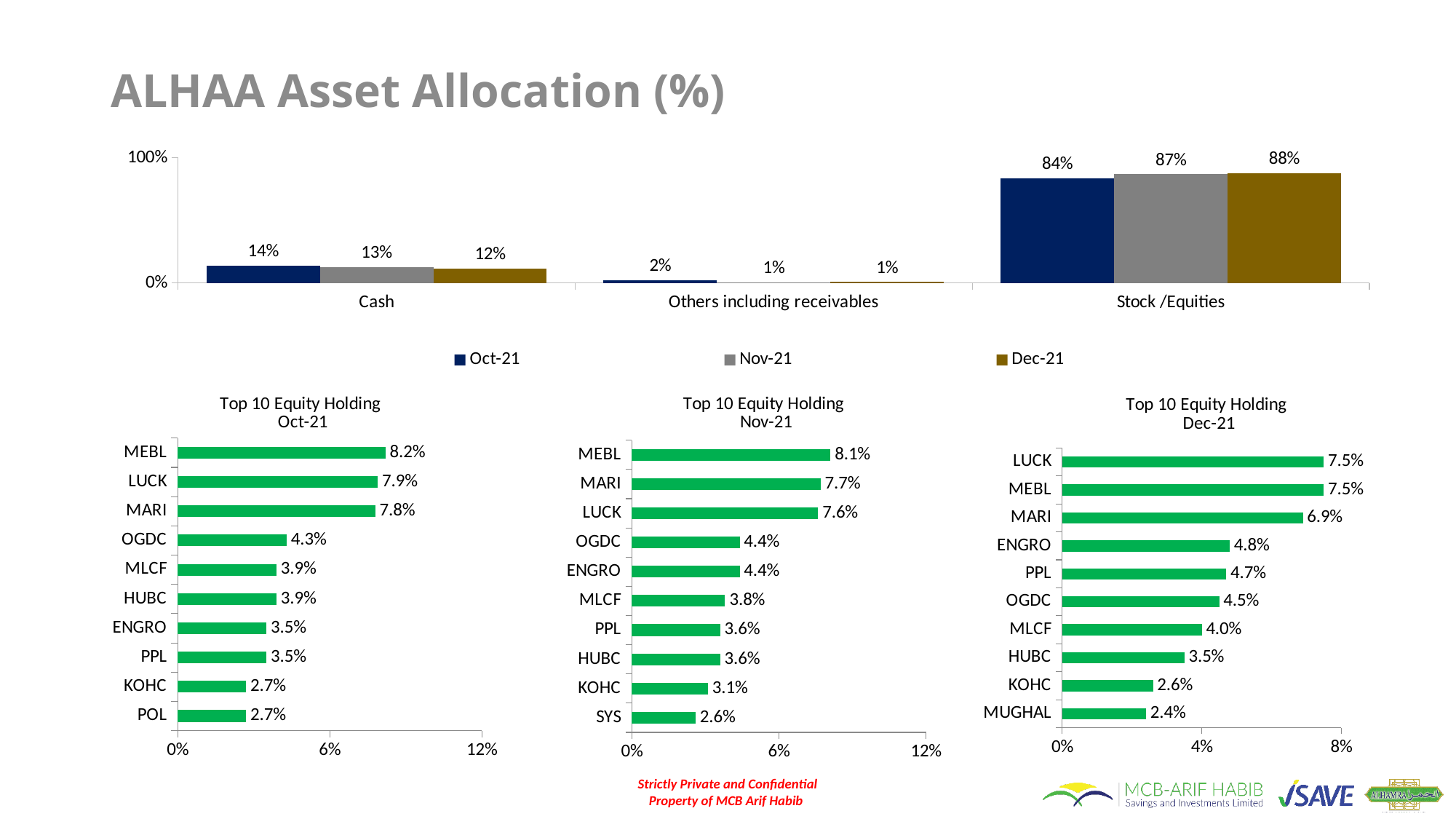
In the Top 10 Equity Holding Dec-21 chart, what is the difference between the values for ENGRO and MUGHAL? 2.4% In the Top 10 Equity Holding Nov-21 chart, what is the value for KOHC? 3.1% In the Top 10 Equity Holding Oct-21 chart, what is the value for OGDC? 4.3% In the ALHAA Asset Allocation chart at the top, what is the Cash value for Dec-21? 12% In the Top 10 Equity Holding Nov-21 chart, which holding has the lowest value? SYS In the Top 10 Equity Holding Dec-21 chart, what is the value for MARI? 6.9% In the Top 10 Equity Holding Oct-21 chart, which holding has the highest value? MEBL In the ALHAA Asset Allocation chart at the top, what is the Stock /Equities value for Nov-21? 87% In the ALHAA Asset Allocation chart at the top, how many series does the legend list? 3 What kind of chart is the Top 10 Equity Holding Dec-21 chart? bar chart In the ALHAA Asset Allocation chart at the top, what is the difference between the Stock /Equities values for Dec-21 and Oct-21? 4% In the ALHAA Asset Allocation chart at the top, does the Cash value rise or fall from Oct-21 to Dec-21? fall